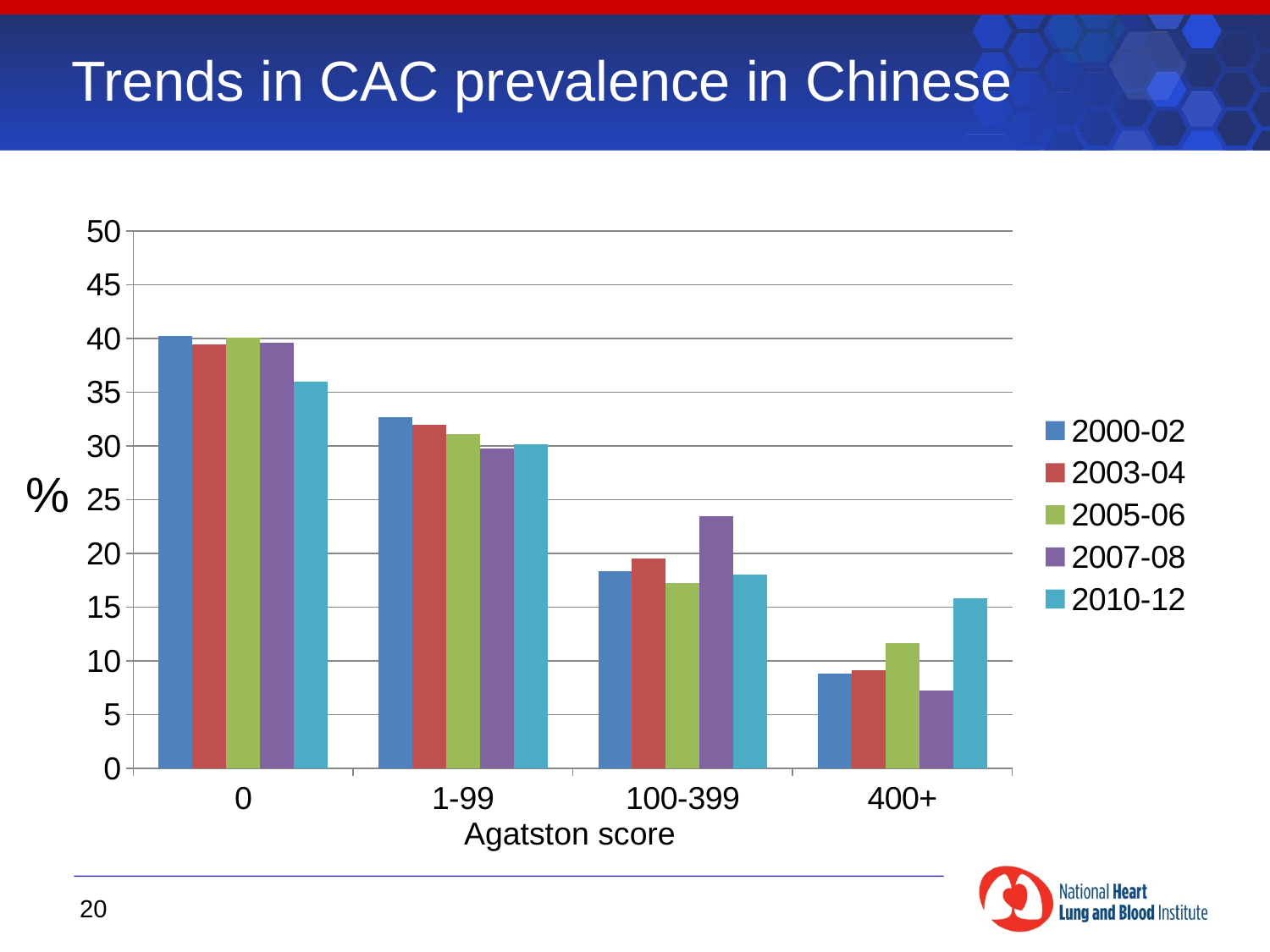
How many series does the legend list? 5 Is the value for 2005-06 in the 400+ category greater or less than 10? greater Which period has the lowest value in the 400+ category? 2007-08 Is the value for 2010-12 in the Agatston score 0 category greater or less than 40? less Do the values for the 2000-02 series rise or fall as the Agatston score category increases from 0 to 400+? fall In the Agatston score 0 category, which is larger: the value for 2000-02 or for 2010-12? 2000-02 Which period has the lowest value in the Agatston score 0 category? 2010-12 Which period has the highest value in the 100-399 category? 2007-08 Which period has the highest value in the 400+ category? 2010-12 Is the value for 2007-08 in the 100-399 category greater or less than 20? greater What kind of chart is shown on the slide? bar chart How many Agatston score categories are shown on the x axis? 4